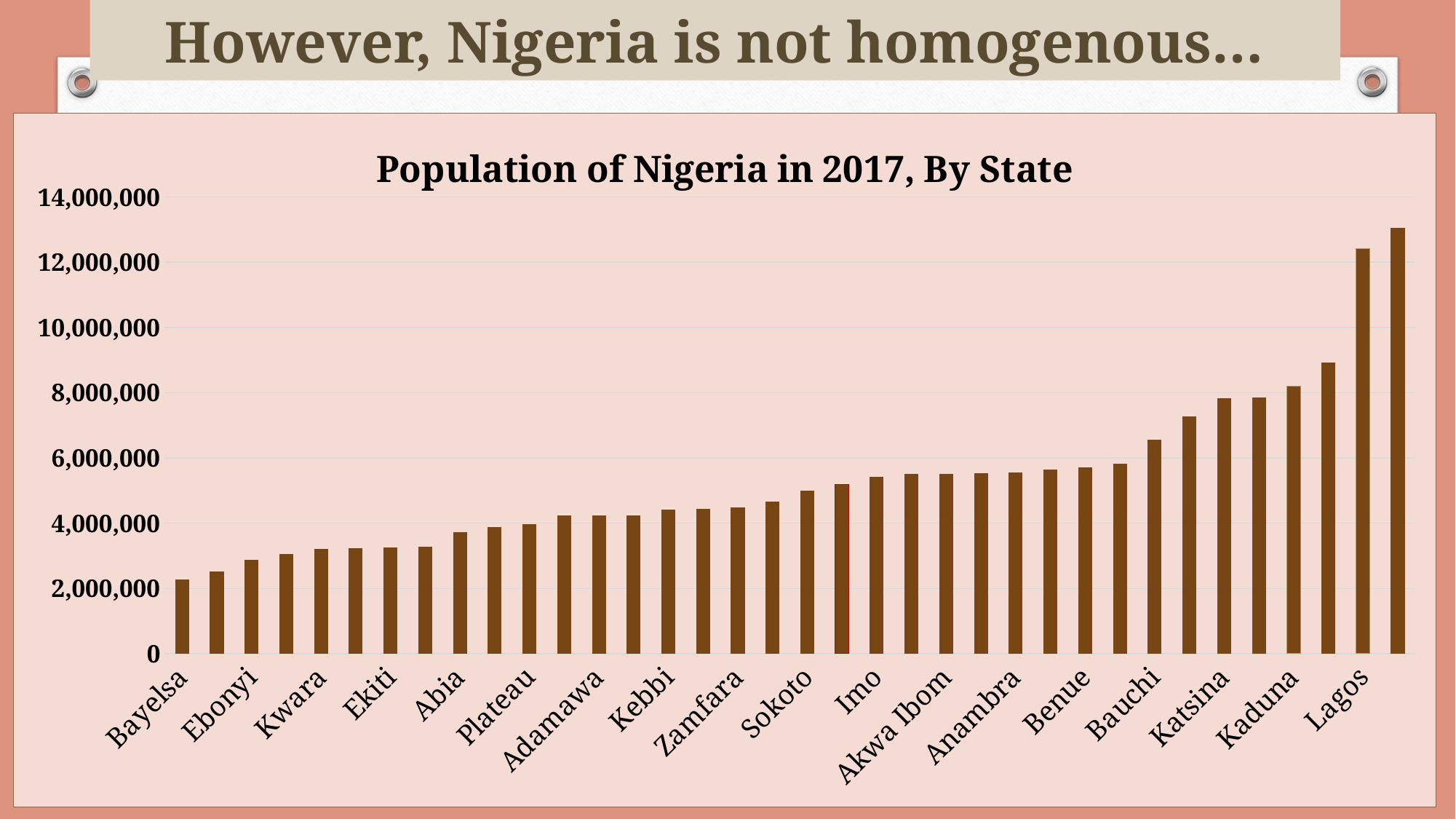
Is the value for Zamfara greater or less than 4,000,000? greater Which labeled state has the lowest population in the chart? Bayelsa Which has the larger population, Lagos or Bayelsa? Lagos Is the value for Benue greater or less than 6,000,000? less What kind of chart is shown on the slide? bar chart Is the value for Bayelsa greater or less than 4,000,000? less Which has the larger population, Bauchi or Benue? Bauchi What is the title of the chart? Population of Nigeria in 2017, By State Do the bars generally rise or fall from left to right along the x axis? rise